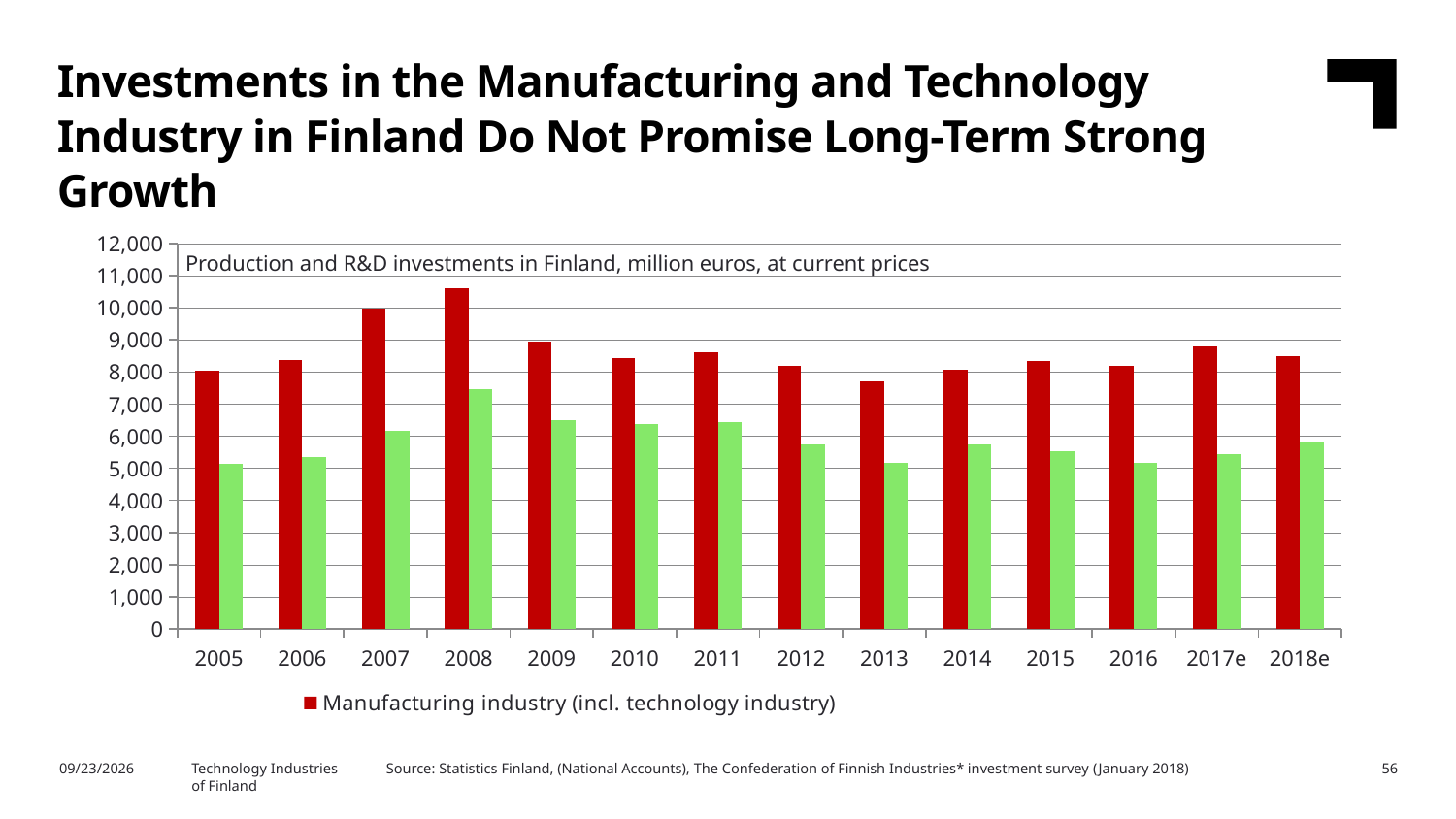
How many series does the chart's legend list? 1 What is the text shown inside the chart area describing the data? Production and R&D investments in Finland, million euros, at current prices Is the green bar for 2008 greater or less than 7,000? greater Is the green bar for 2012 greater or less than 6,000? less What kind of chart is shown on the slide? Bar chart Which year has the larger Manufacturing industry (incl. technology industry) value, 2007 or 2008? 2008 In which year is the Manufacturing industry (incl. technology industry) bar the lowest? 2013 Is the Manufacturing industry (incl. technology industry) value for 2013 greater or less than 8,000? less How many years are shown on the x axis of the chart? 14 In which year is the Manufacturing industry (incl. technology industry) bar the highest? 2008 Do the Manufacturing industry (incl. technology industry) values rise or fall from 2005 to 2008? Rise